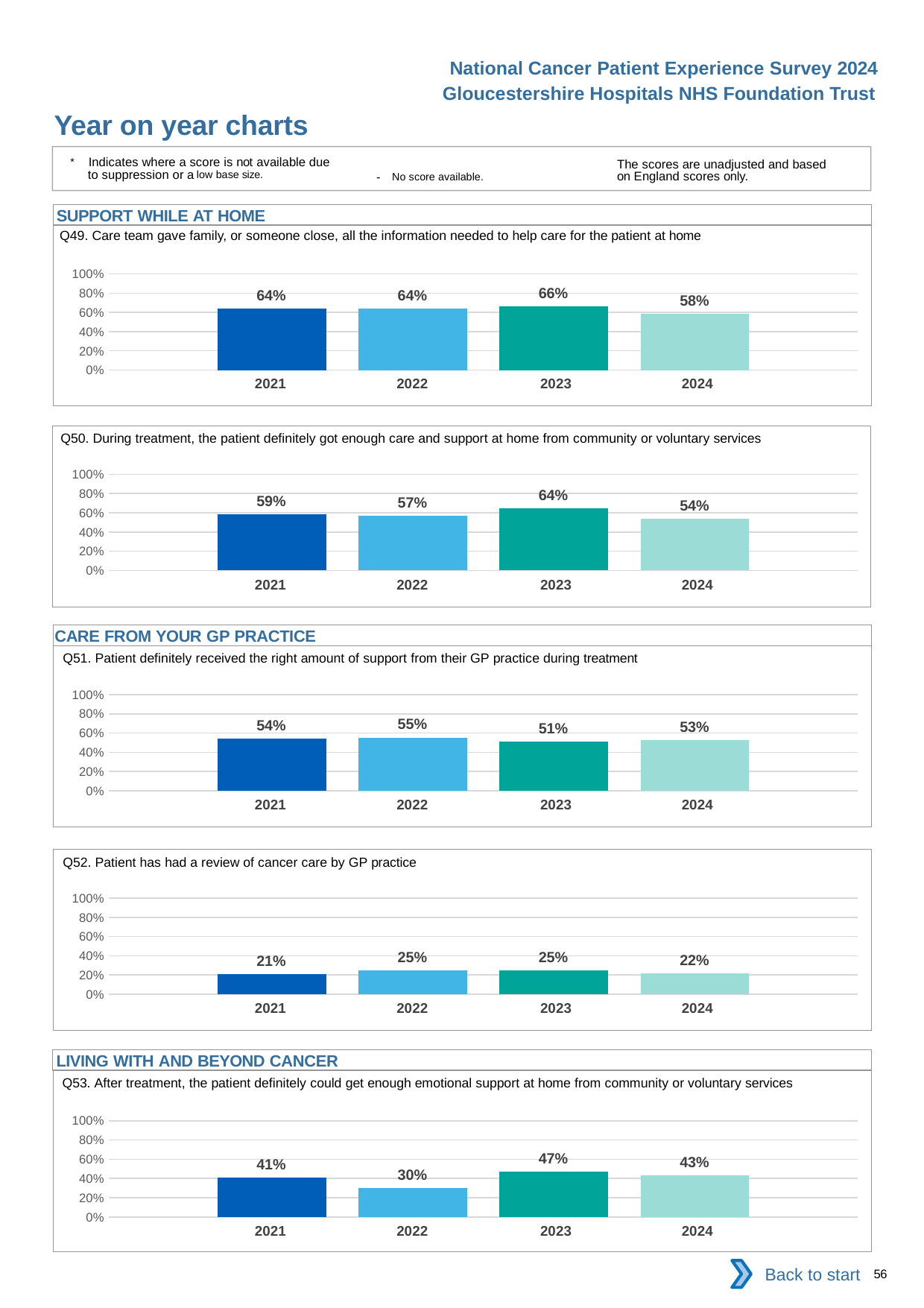
How many years are plotted in the Q53 chart? 4 In the Q51 chart, which is larger, the value for 2021 or the value for 2023? 2021 In the Q51 chart, what is the value for 2022? 55% In the Q50 chart, which year has the lowest value? 2024 In the Q52 chart, what is the value for 2021? 21% In the Q53 chart, what is the difference between the 2023 and 2022 values? 17 percentage points In the Q49 chart, what is the value for 2024? 58% In the Q53 chart, which year has the lowest value? 2022 What kind of chart is the Q49 chart? Bar chart In the Q49 chart, which year has the highest value? 2023 In the Q50 chart, what is the difference between the 2023 and 2024 values? 10 percentage points In the Q52 chart, is the value for 2023 greater or less than 40%? less